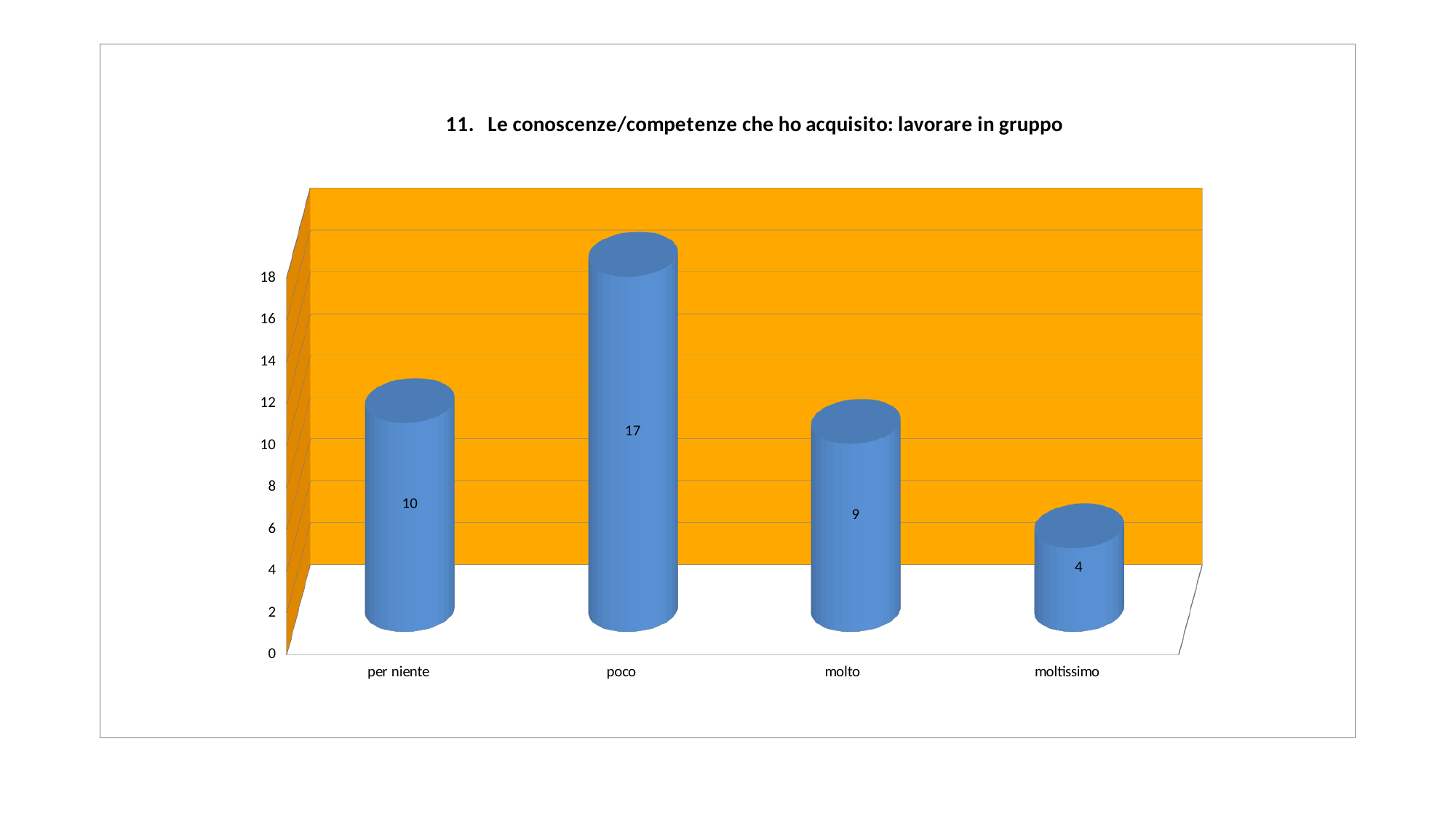
What is the difference between the values for "poco" and "per niente"? 7 How many categories are shown on the x axis? 4 What is the value for "molto"? 9 What kind of chart is shown on the slide? bar chart What is the value for "moltissimo"? 4 What is the difference between the values for "molto" and "moltissimo"? 5 Which is larger, the value for "per niente" or the value for "moltissimo"? per niente Which category has the lowest value? moltissimo What is the value for "per niente"? 10 Which category has the highest value? poco What is the value for "poco"? 17 What is the title of the chart? 11. Le conoscenze/competenze che ho acquisito: lavorare in gruppo